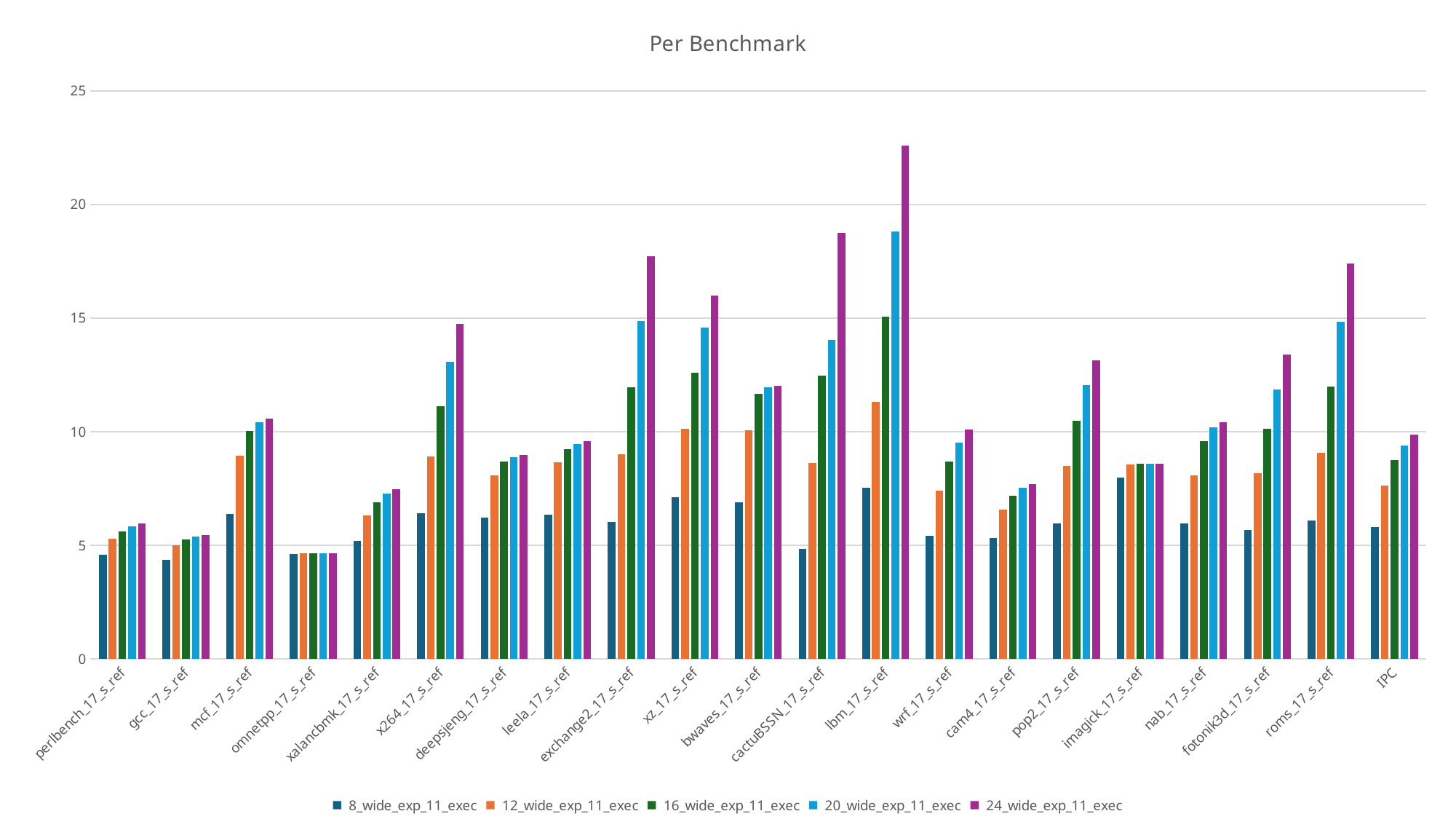
Which category has the highest value for the 8_wide_exp_11_exec series? imagick_17_s_ref Is the value for omnetpp_17_s_ref in the 8_wide_exp_11_exec series greater or less than 5? less Is the value for exchange2_17_s_ref in the 24_wide_exp_11_exec series greater or less than 15? greater Which category has the lowest value for the 24_wide_exp_11_exec series? omnetpp_17_s_ref How many series does the legend list? 5 How many benchmark categories are shown on the x axis? 21 What is the title of the chart? Per Benchmark What kind of chart is shown on the slide? bar chart Is the value for lbm_17_s_ref in the 20_wide_exp_11_exec series greater or less than 20? less In the 24_wide_exp_11_exec series, which is larger: roms_17_s_ref or x264_17_s_ref? roms_17_s_ref Which category has the highest value for the 24_wide_exp_11_exec series? lbm_17_s_ref